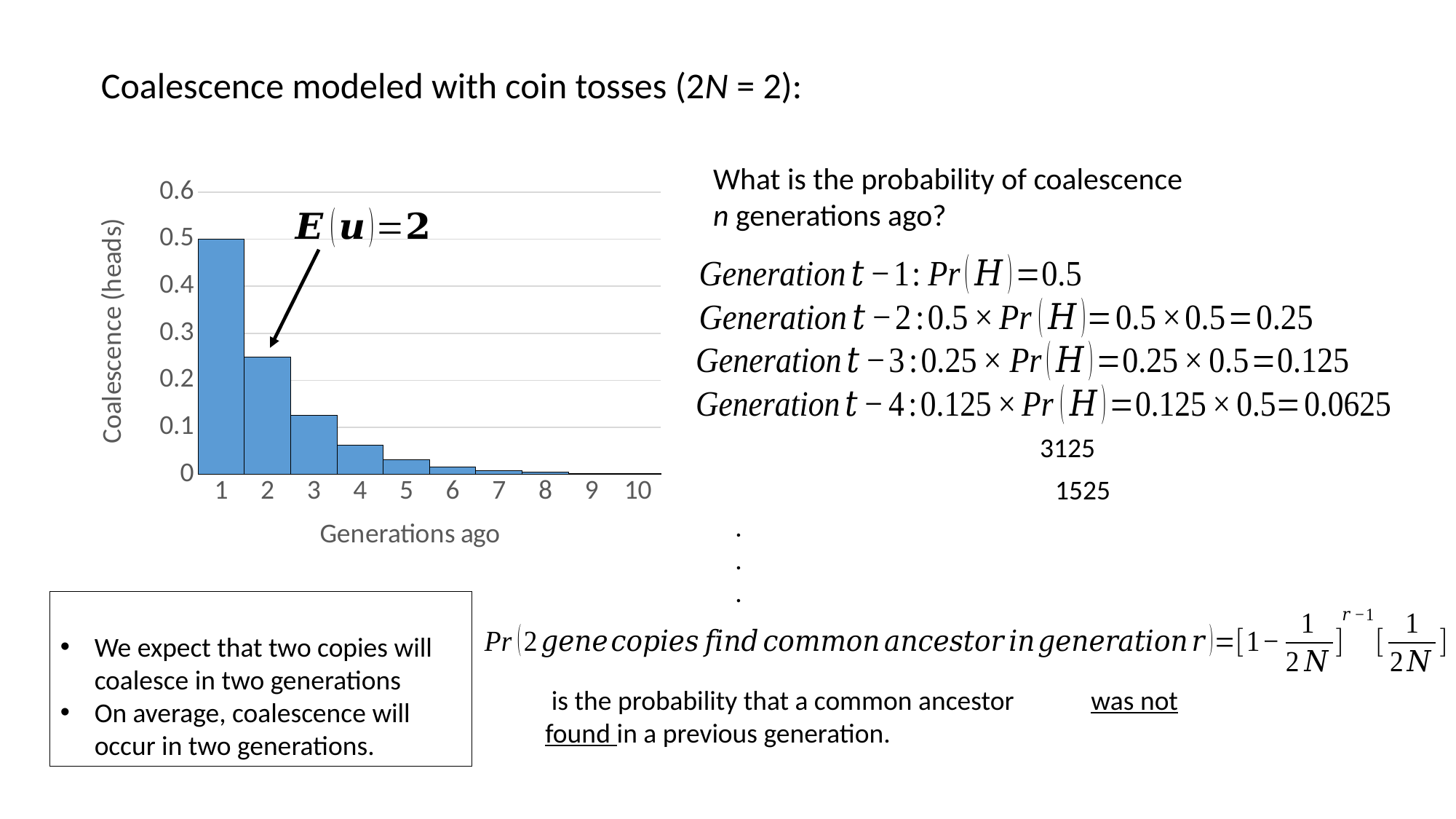
Which generation ago has the lowest coalescence value in the chart? 10 Is the coalescence value for generation 3 greater or less than 0.1? greater What is the title of the x axis of the chart? Generations ago What kind of chart is shown on the slide? bar chart Is the coalescence value for generation 2 greater or less than 0.3? less How many generations (categories) are shown on the x axis of the chart? 10 Is the coalescence value for generation 4 greater or less than 0.1? less Which generation ago has the highest coalescence value in the chart? 1 What is the coalescence value for generation 1 in the chart? 0.5 Which has a larger coalescence value, generation 2 or generation 3? generation 2 Do the coalescence values rise or fall as generations ago increases along the x axis? fall What is the title of the y axis of the chart? Coalescence (heads)